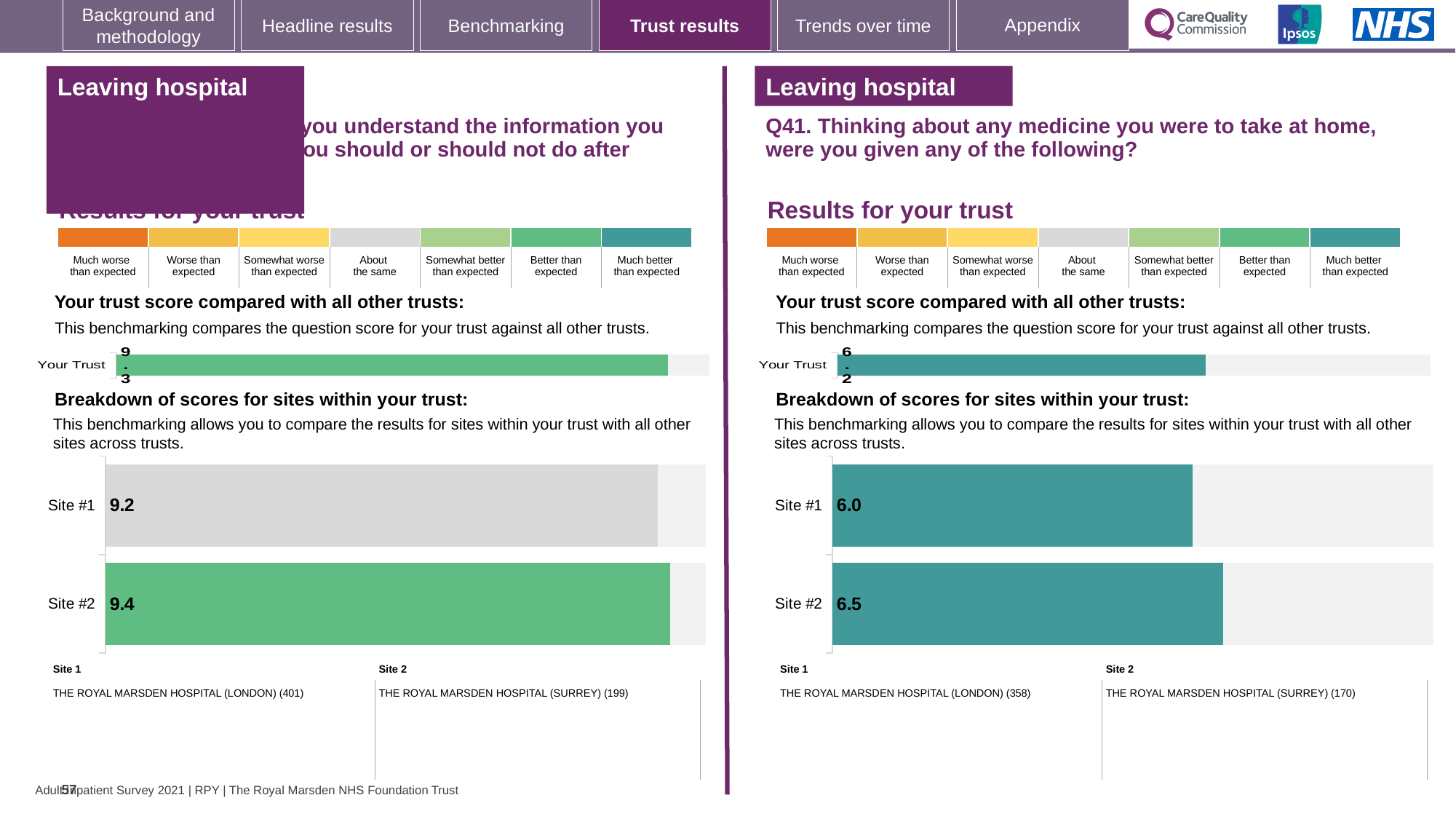
On the left-hand site breakdown chart, what is the score for Site #1? 9.2 On the right-hand (Q41) site breakdown chart, what is the score for Site #2? 6.5 On the left-hand 'Your Trust' benchmarking bar, what is the trust score shown? 9.3 On the left-hand site breakdown chart, what is the score for Site #2? 9.4 On the right-hand (Q41) site breakdown chart, which site has the higher score? Site #2 On the left-hand site breakdown chart, which site has the lower score? Site #1 How many sites are shown in the right-hand (Q41) site breakdown chart? 2 What type of chart is used for the site breakdown on the left-hand side of the slide? Bar chart On the right-hand (Q41) site breakdown chart, what is the score for Site #1? 6.0 On the right-hand (Q41) 'Your Trust' benchmarking bar, what is the trust score shown? 6.2 On the right-hand (Q41) site breakdown chart, what is the difference between the Site #2 and Site #1 scores? 0.5 On the left-hand site breakdown chart, what is the difference between the Site #2 and Site #1 scores? 0.2